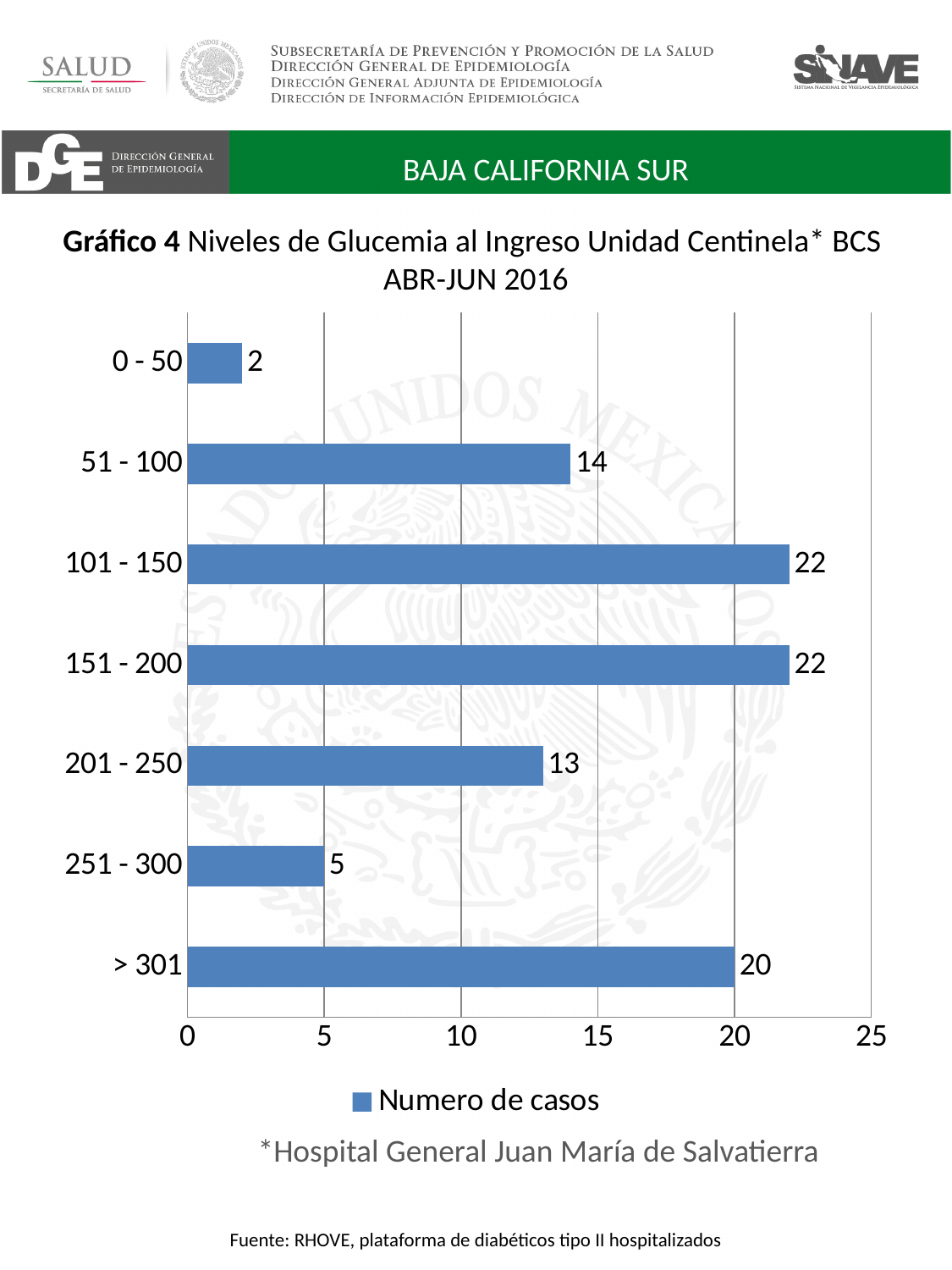
What is the number of cases for the 101 - 150 glucose level category? 22 How many series does the legend list? 1 What is the legend entry for the series in the chart? Numero de casos What is the difference in cases between the > 301 and 251 - 300 categories? 15 Is the value for 151 - 200 greater or less than 20? greater What is the difference in cases between the 51 - 100 and 201 - 250 categories? 1 What kind of chart is shown on the slide? Bar chart What is the number of cases for the > 301 category? 20 Which has more cases, 51 - 100 or 251 - 300? 51 - 100 How many glucose level categories are shown in the chart? 7 What is the number of cases for the 0 - 50 category? 2 Which category has the lowest number of cases? 0 - 50